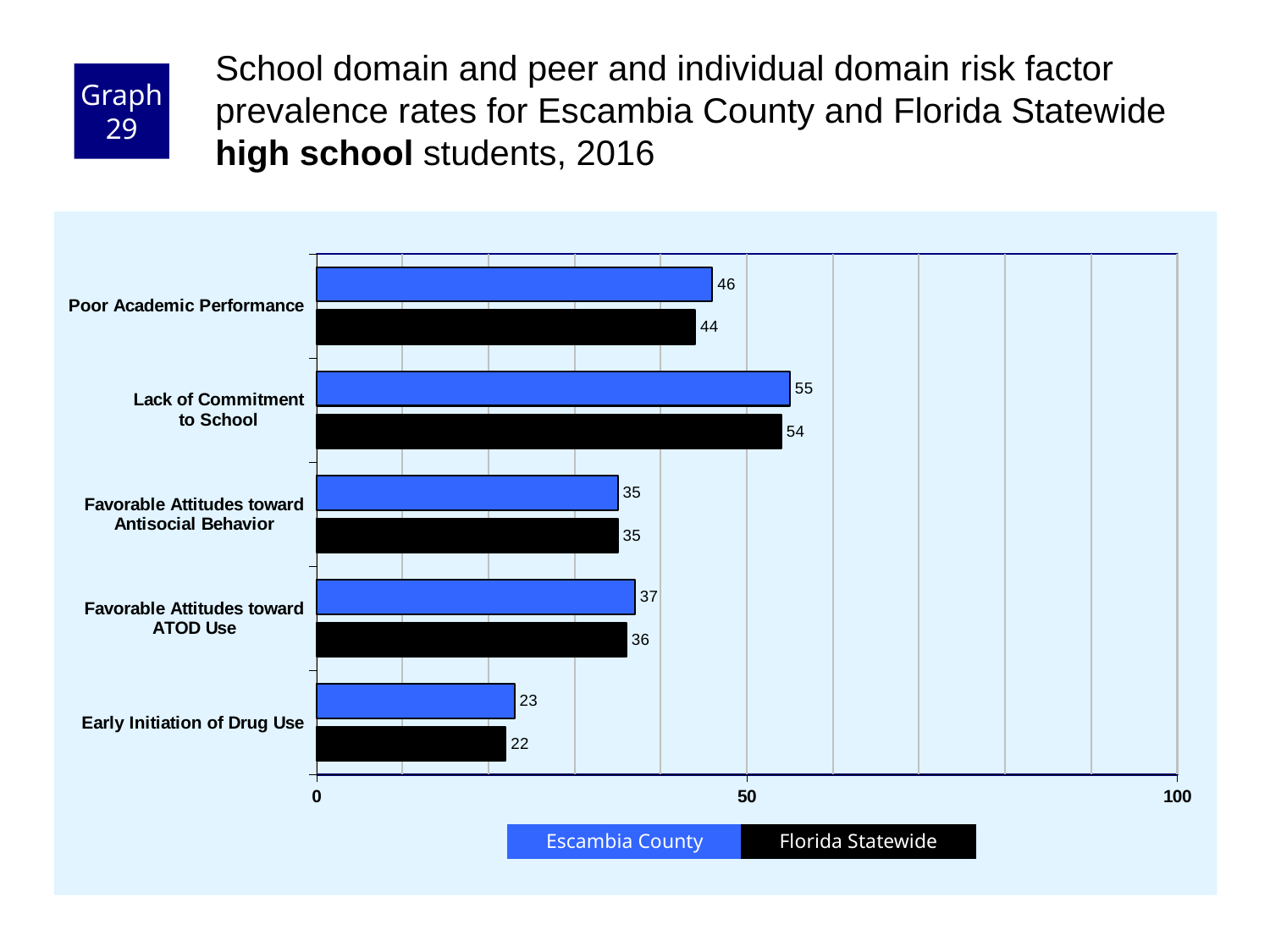
Which colour represents Florida Statewide in the chart? Black What is the Florida Statewide value for Favorable Attitudes toward ATOD Use? 36 Which risk factor has the highest Escambia County value? Lack of Commitment to School How many series does the legend list? 2 Which risk factor has the lowest Florida Statewide value? Early Initiation of Drug Use What is the difference between the Escambia County and Florida Statewide values for Poor Academic Performance? 2 What kind of chart is shown on the slide? Bar chart Which is larger for Lack of Commitment to School: the Escambia County value or the Florida Statewide value? Escambia County How many risk factors are shown on the chart? 5 What is the Escambia County value for Early Initiation of Drug Use? 23 What is the Escambia County value for Poor Academic Performance? 46 What is the Florida Statewide value for Lack of Commitment to School? 54